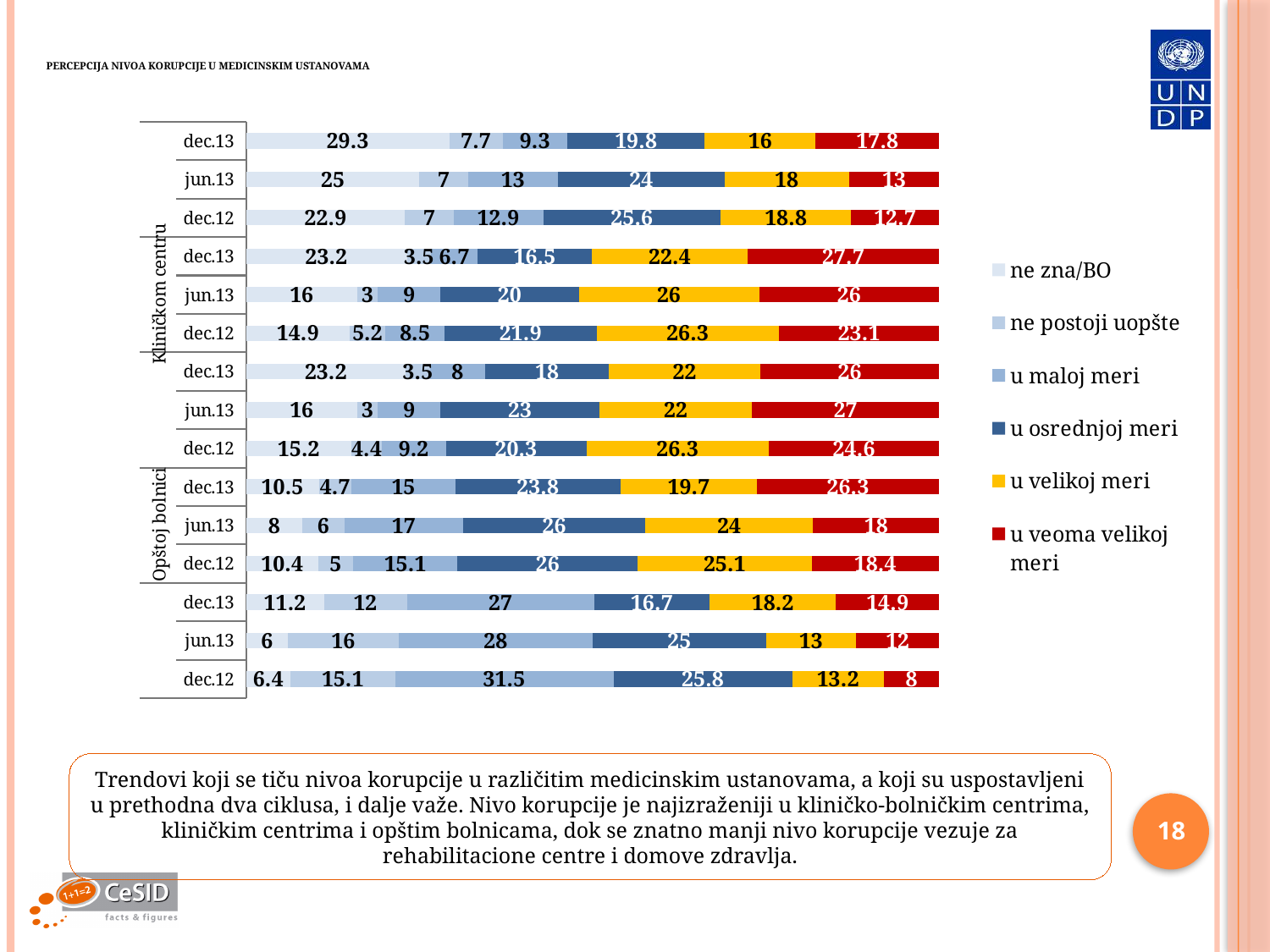
In the bottom bar of the chart (dec.12), what is the difference between the 'u maloj meri' value and the 'u veoma velikoj meri' value? 23.5 In the Opštoj bolnici group, what is the 'ne zna/BO' value for dec.12? 10.4 What is the total of the Opštoj bolnici dec.13 stacked bar? 100 What kind of chart is shown on the slide? bar chart How many bars are plotted in the chart? 15 In the Kliničkom centru dec.13 bar, which is larger: 'u veoma velikoj meri' or 'u velikoj meri'? u veoma velikoj meri How many series does the legend list? 6 In the bottom bar of the chart (dec.12), what is the 'u maloj meri' value? 31.5 In the Opštoj bolnici group, what is the 'u osrednjoj meri' value for jun.13? 26 In the topmost bar of the chart (dec.13), what is the 'ne zna/BO' value? 29.3 What colour represents 'u veoma velikoj meri' in the legend? red In the Kliničkom centru group, what is the 'u veoma velikoj meri' value for dec.13? 27.7